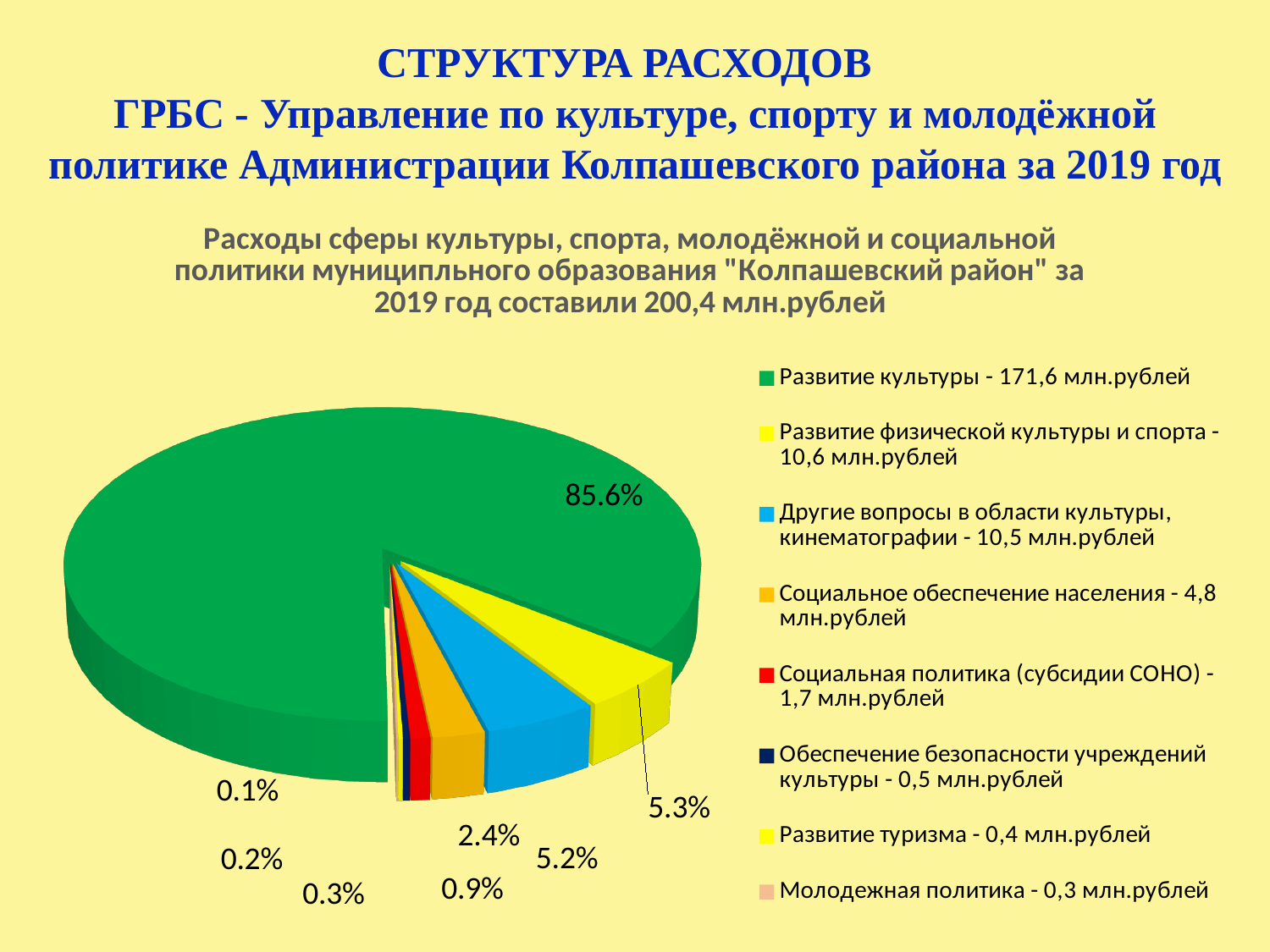
Which category has the smallest amount in the legend? Молодежная политика According to the legend, what is the amount for Социальная политика (субсидии СОНО)? 1,7 млн.рублей What total amount of expenditure for 2019 is stated in the chart title? 200,4 млн.рублей Which category has the largest share of the pie? Развитие культуры How many categories does the pie chart legend list? 8 What type of chart is shown on the slide? pie chart Based on the legend amounts, which is larger: Развитие физической культуры и спорта or Другие вопросы в области культуры, кинематографии? Развитие физической культуры и спорта What percentage of the pie is labelled for Социальное обеспечение населения? 2.4% According to the legend, what is the amount for Социальное обеспечение населения? 4,8 млн.рублей According to the legend, what is the amount for Развитие культуры? 171,6 млн.рублей What is the difference between the legend amounts for Социальное обеспечение населения and Социальная политика (субсидии СОНО)? 3,1 млн.рублей What percentage of the pie is labelled for Развитие культуры? 85.6%